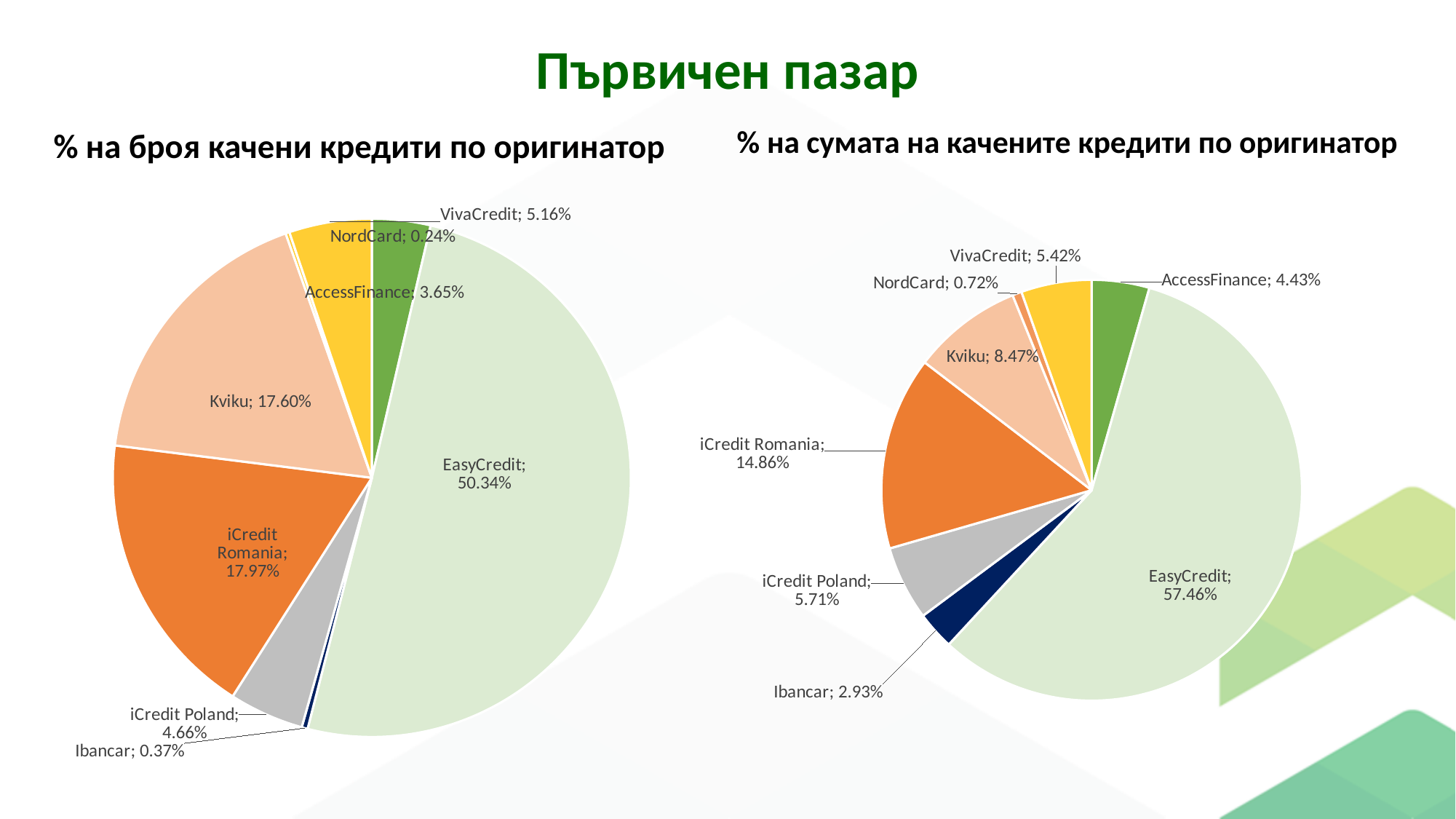
In the left chart (% на броя качени кредити по оригинатор), what is the difference between the shares of iCredit Romania and Kviku? 0.37% How many originators (slices) are shown in the left chart (% на броя качени кредити по оригинатор)? 8 In the left chart (% на броя качени кредити по оригинатор), what is the share for Ibancar? 0.37% What type of chart is used on this slide? Pie chart In the right chart (% на сумата на качените кредити по оригинатор), what is the share for Kviku? 8.47% What is the main title of the slide? Първичен пазар In the right chart (% на сумата на качените кредити по оригинатор), which originator has the largest share? EasyCredit In the right chart (% на сумата на качените кредити по оригинатор), which is larger: the share of iCredit Romania or the share of Kviku? iCredit Romania In the left chart (% на броя качени кредити по оригинатор), what is the share for EasyCredit? 50.34% In the right chart (% на сумата на качените кредити по оригинатор), which originator has the smallest share? NordCard In the right chart (% на сумата на качените кредити по оригинатор), what is the share for iCredit Poland? 5.71% In the left chart (% на броя качени кредити по оригинатор), which originator has the smallest share? NordCard